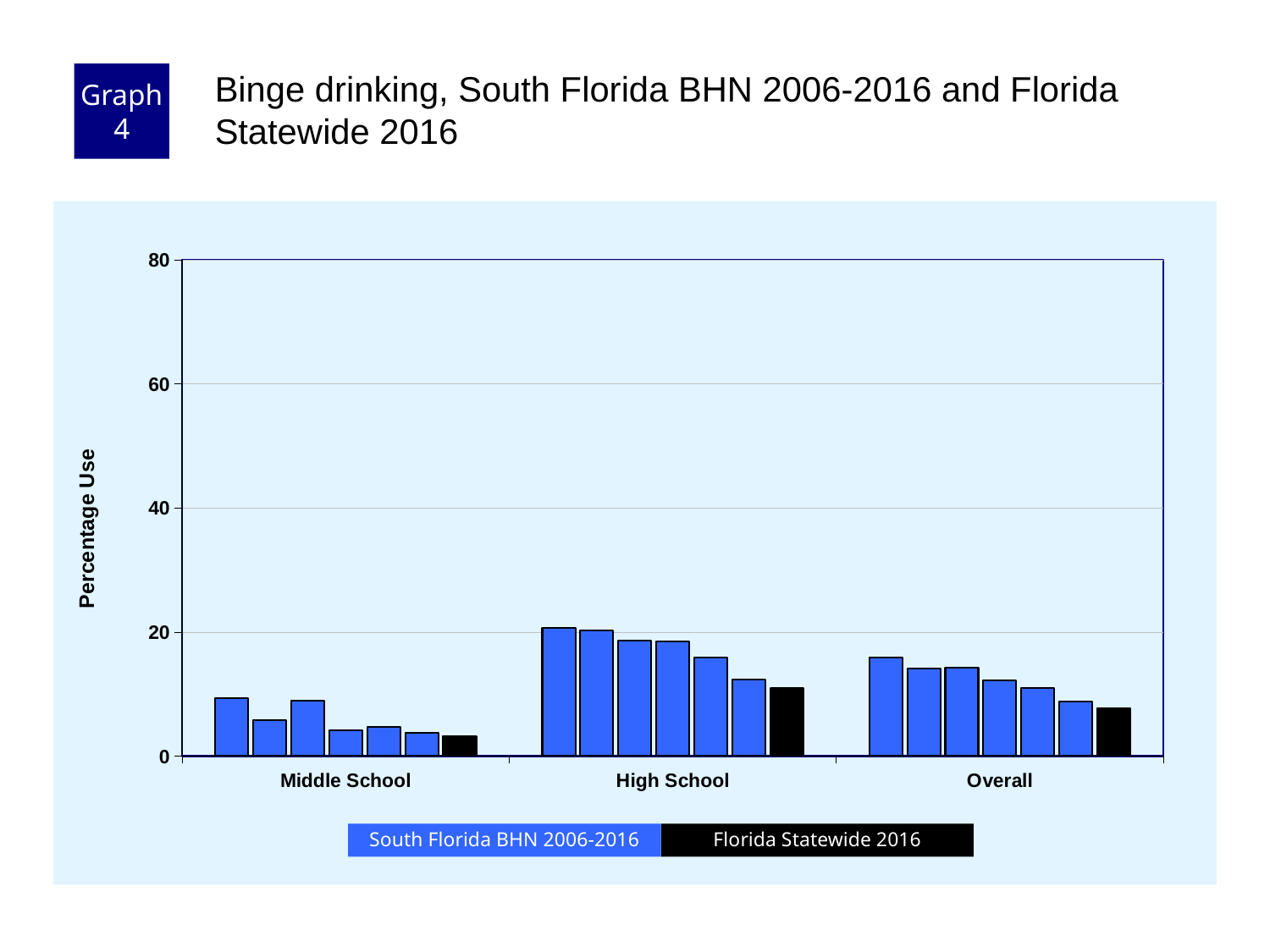
Which category has the highest bars overall? High School How many categories are shown on the x axis? 3 Do the South Florida BHN 2006-2016 bars for High School rise or fall from left to right? fall Is the value of the tallest Middle School bar greater or less than 20? less Which category has the lowest bars overall? Middle School What colour are the Florida Statewide 2016 bars? black Which is larger, the Florida Statewide 2016 value for High School or for Middle School? High School How many series does the legend list? 2 What is the label on the y axis? Percentage Use What kind of chart is shown on the slide? bar chart Is the Florida Statewide 2016 value for High School greater or less than 20? less Is the value of the tallest High School bar greater or less than 40? less